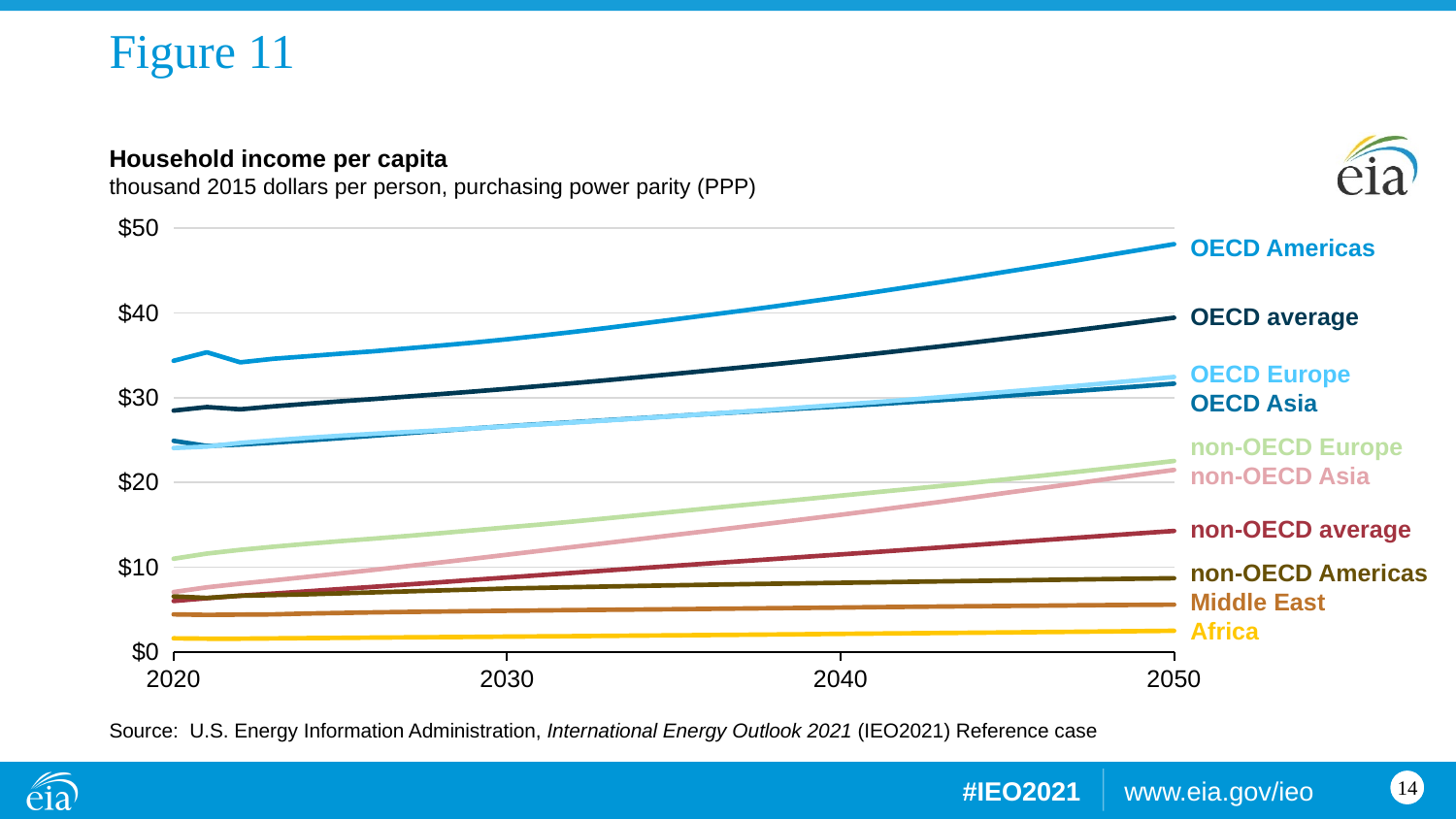
What kind of chart is shown on the slide? line chart Which series has the highest household income per capita in 2050? OECD Americas Is the value for OECD Americas in 2050 greater or less than $40? greater Does the OECD Americas line rise or fall from 2020 to 2050? rise In 2020, which is larger: non-OECD Europe or non-OECD Asia? non-OECD Europe How many series are labelled on the chart? 10 What is the title of the chart? Household income per capita Is the value for Africa in 2050 greater or less than $10? less Which series has the lowest household income per capita across the chart? Africa Is the value for OECD Americas in 2020 greater or less than $30? greater In 2050, which is larger: OECD Americas or OECD average? OECD Americas